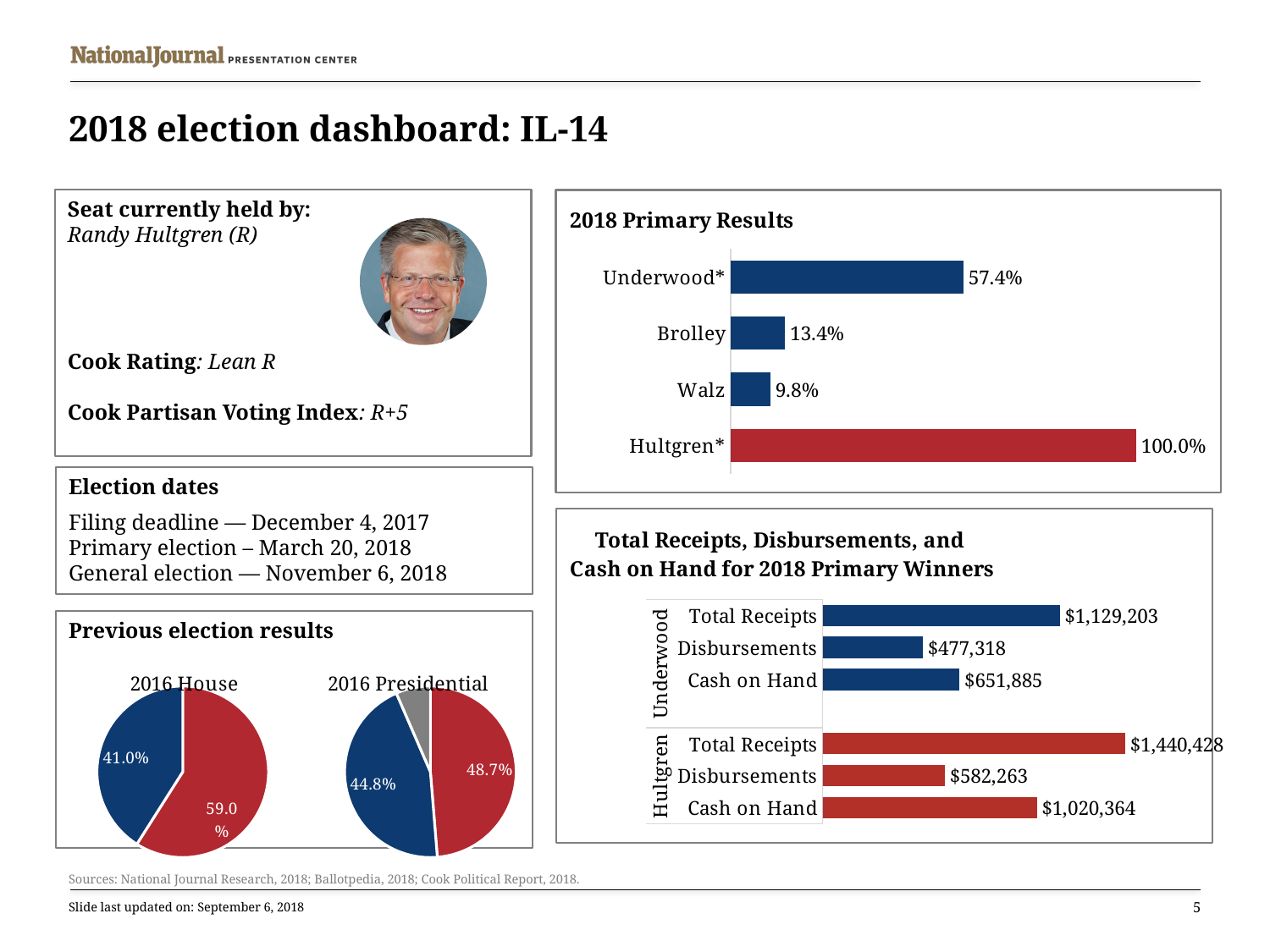
In the Total Receipts, Disbursements, and Cash on Hand chart, what are Underwood's Total Receipts? $1,129,203 In the Total Receipts, Disbursements, and Cash on Hand chart, how much greater are Hultgren's Total Receipts than Underwood's? $311,225 In the Total Receipts, Disbursements, and Cash on Hand chart, what is Hultgren's Cash on Hand? $1,020,364 In the 2018 Primary Results chart, how many candidates are shown? 4 In the 2018 Primary Results chart, what percentage did Underwood* receive? 57.4% In the 2018 Primary Results chart, which candidate has the highest percentage? Hultgren* In the 2018 Primary Results chart, which candidate has the lowest percentage? Walz In the Total Receipts, Disbursements, and Cash on Hand chart, which candidate has higher Disbursements, Underwood or Hultgren? Hultgren In the 2016 House pie chart, what share does the red slice represent? 59.0% What kind of chart is the 2018 Primary Results chart? Bar chart In the 2018 Primary Results chart, what percentage did Walz receive? 9.8% In the 2018 Primary Results chart, what is the difference in percentage points between Underwood* and Brolley? 44.0